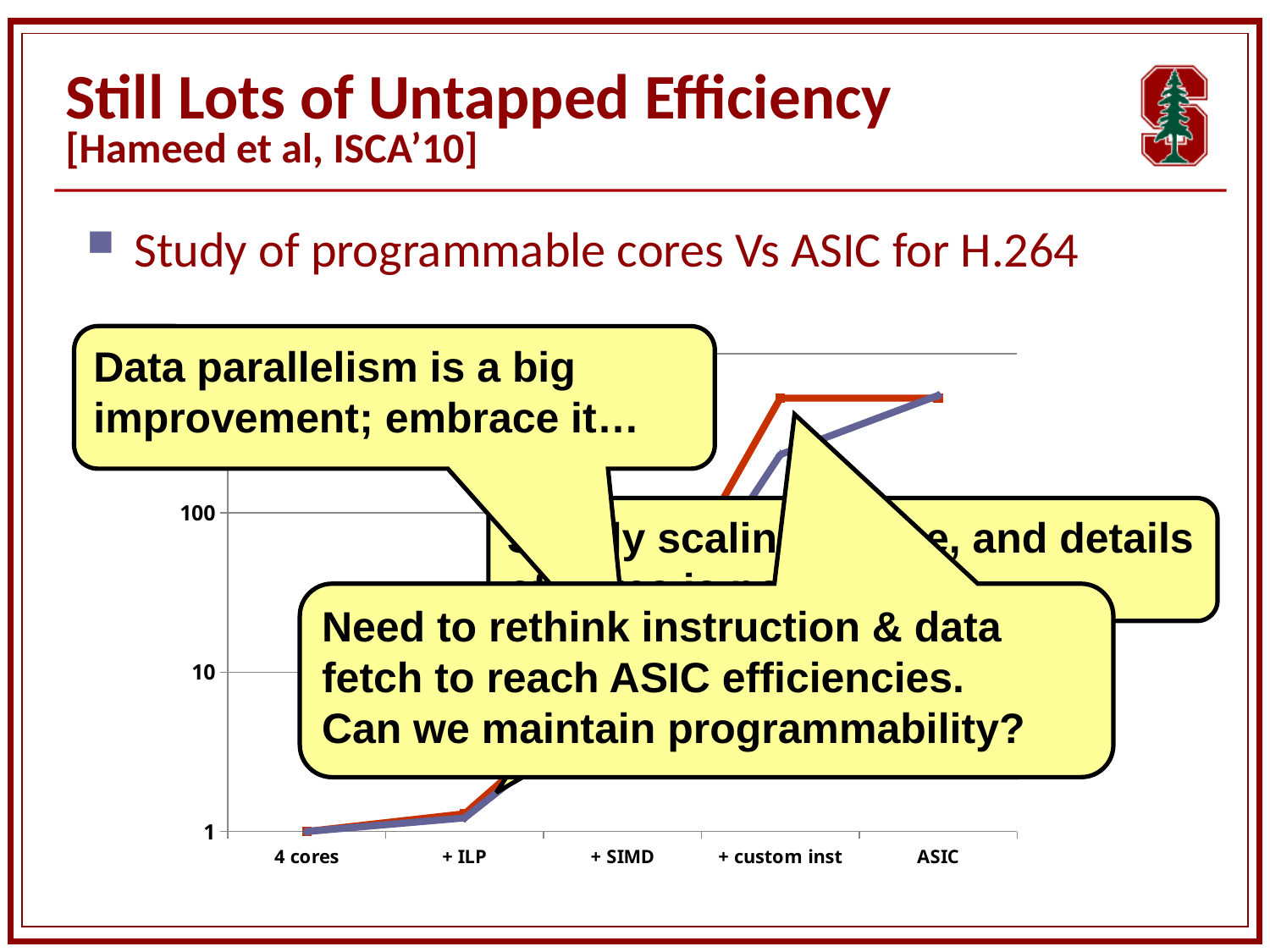
How many categories are shown on the x axis of the chart? 5 What is the first category on the x axis of the chart? 4 cores Which has the larger value, + ILP or + custom inst? + custom inst Is the value for + custom inst greater or less than 100? greater Which category has the lowest value on the chart? 4 cores Is the value for ASIC greater or less than 100? greater Do the plotted values rise or fall moving from 4 cores to ASIC along the x axis? rise Is the value for + ILP greater or less than 10? less Which has the larger value, 4 cores or ASIC? ASIC What is the last category on the x axis of the chart? ASIC How many lines are plotted on the chart? 2 What kind of chart is shown on the slide? line chart